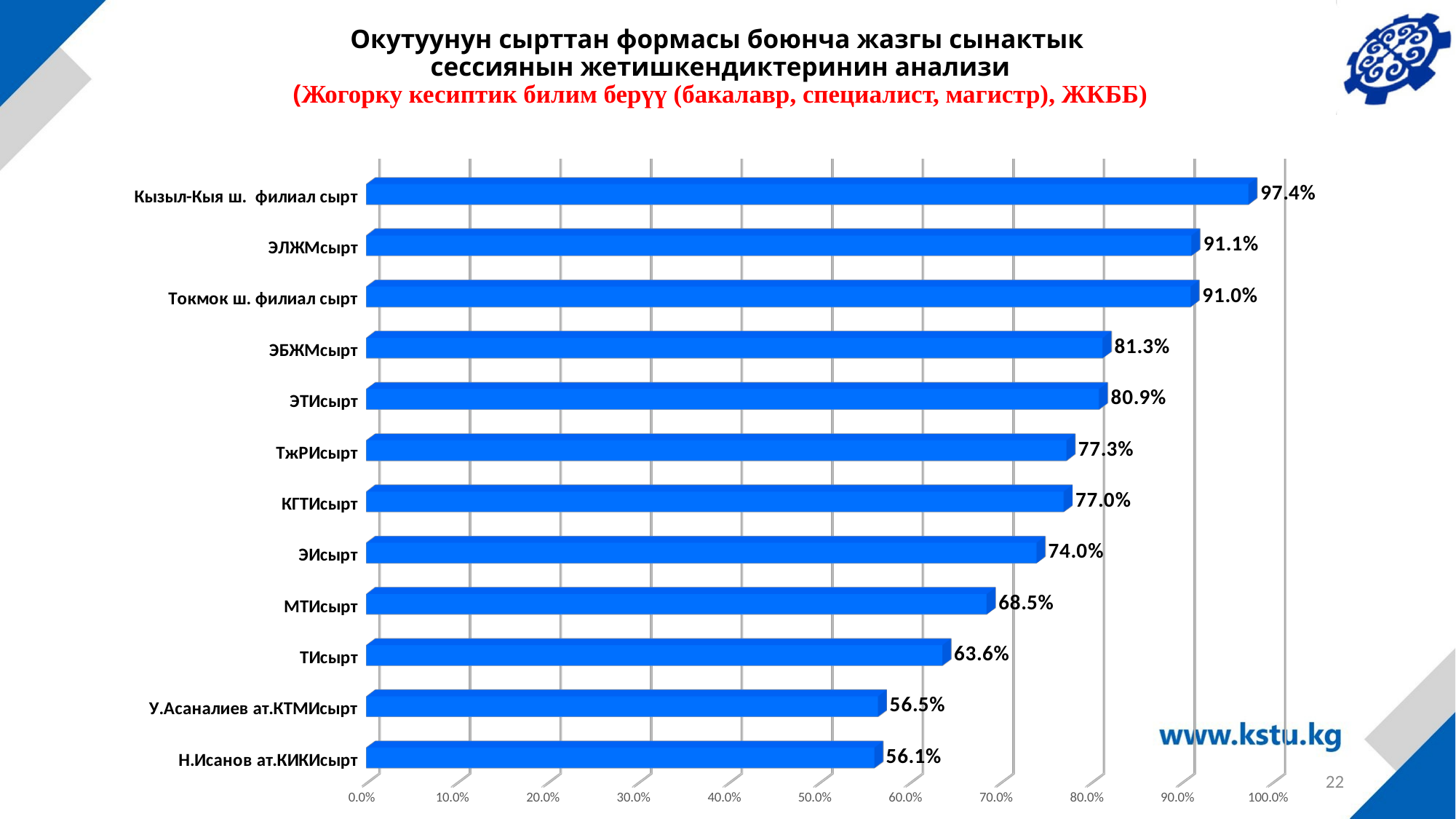
Which category has the highest value? Кызыл-Кыя ш. филиал сырт What kind of chart is shown on the slide? bar chart Which category has the lowest value? Н.Исанов ат.КИКИсырт What is the difference between the values for ЭБЖМсырт and ЭИсырт? 7.3 percentage points What is the value for Кызыл-Кыя ш. филиал сырт? 97.4% Is the value for ТжРИсырт greater or less than 70.0%? greater Which is larger, the value for ТИсырт or the value for ЭТИсырт? ЭТИсырт What is the value for МТИсырт? 68.5% What is the value for У.Асаналиев ат.КТМИсырт? 56.5% How many categories are shown in the chart? 12 What is the value for ЭБЖМсырт? 81.3% What is the difference between the values for Кызыл-Кыя ш. филиал сырт and Н.Исанов ат.КИКИсырт? 41.3 percentage points